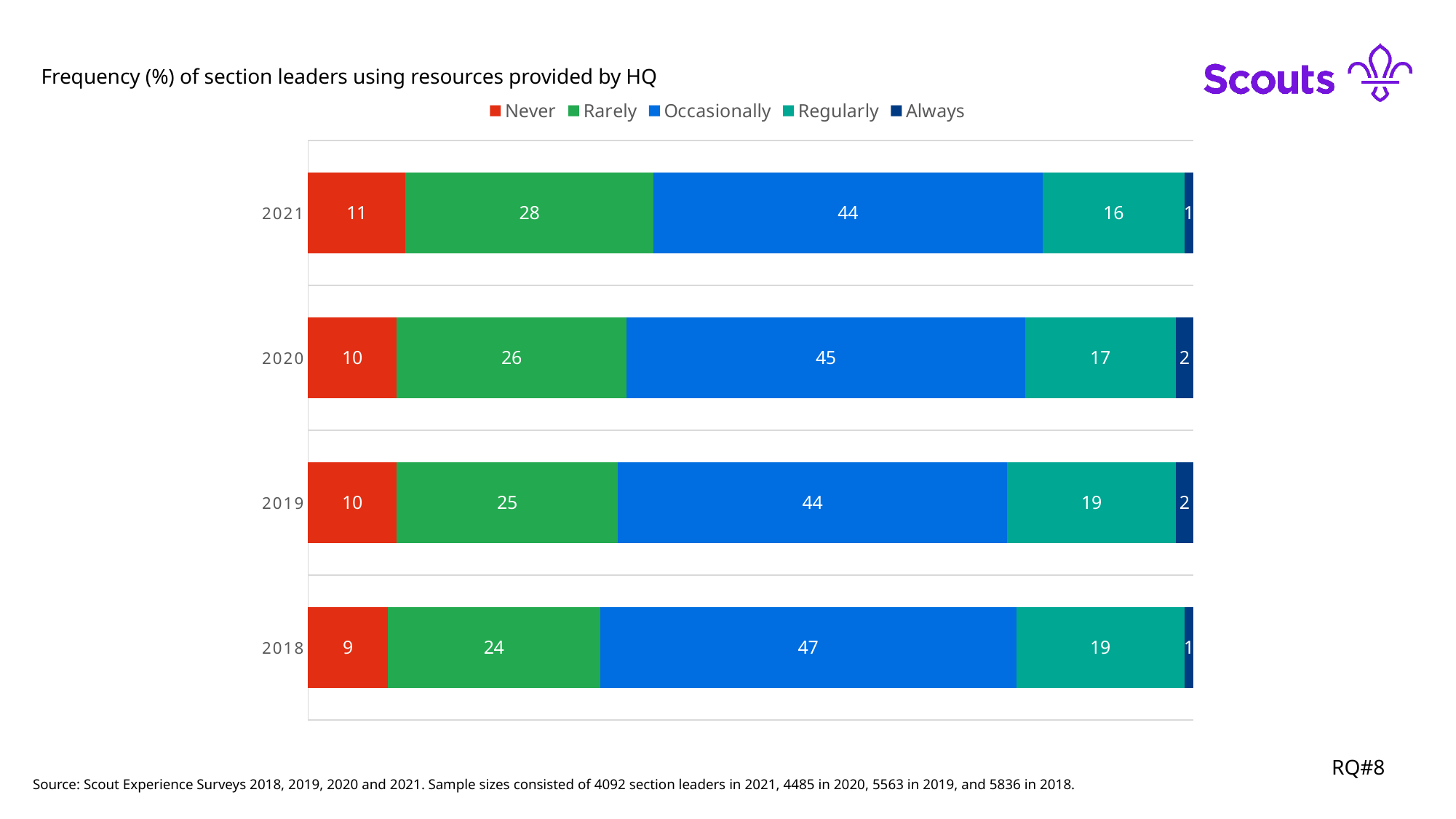
What is the value for Regularly in 2019? 19 What is the value for Occasionally in 2018? 47 Is the Regularly value larger in 2019 or in 2021? 2019 What percentage of section leaders in 2021 said they never use resources provided by HQ? 11 Which year has the lowest value for Never? 2018 How many years are shown on the chart? 4 What is the difference between the Occasionally values for 2018 and 2021? 3 What kind of chart is shown on the slide? Stacked bar chart What is the total of the stacked bar for 2020? 100 How many series does the legend list? 5 Which year has the highest value for Rarely? 2021 What is the value for Always in 2020? 2